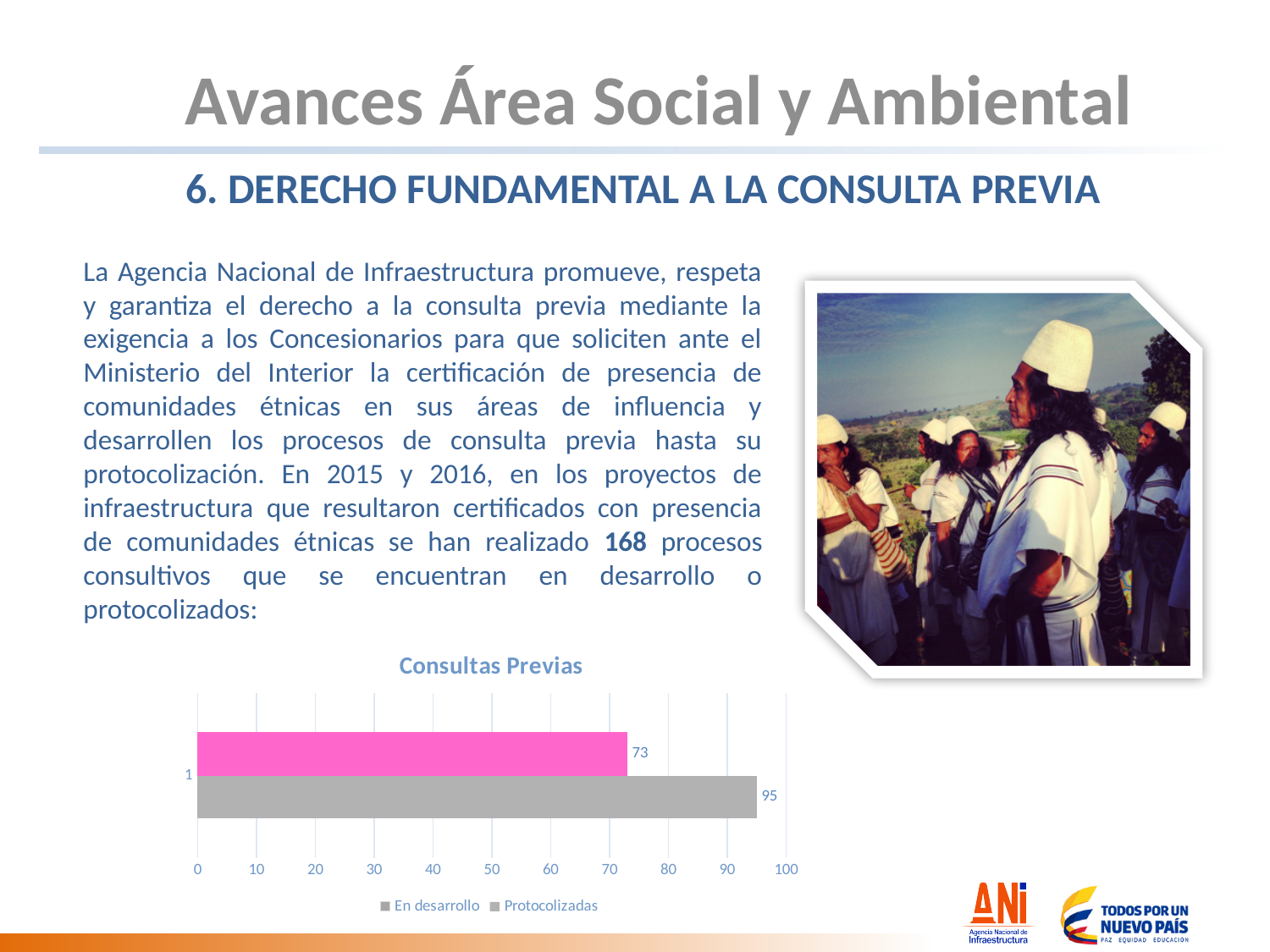
Is the value for Protocolizadas larger or smaller than the value for En desarrollo? larger Is the value for En desarrollo greater or less than 80? less What is the difference between the Protocolizadas value and the En desarrollo value in the Consultas Previas chart? 22 What is the total of the two series values shown in the Consultas Previas chart? 168 What type of chart is shown on the slide? bar chart Which series has the higher value in the Consultas Previas chart? Protocolizadas Which series has the lower value in the Consultas Previas chart? En desarrollo How many series does the legend of the Consultas Previas chart list? 2 What is the value for the 'Protocolizadas' series in the Consultas Previas chart? 95 What is the value for the 'En desarrollo' series in the Consultas Previas chart? 73 Is the value for Protocolizadas greater or less than 90? greater What is the title of the chart on the slide? Consultas Previas